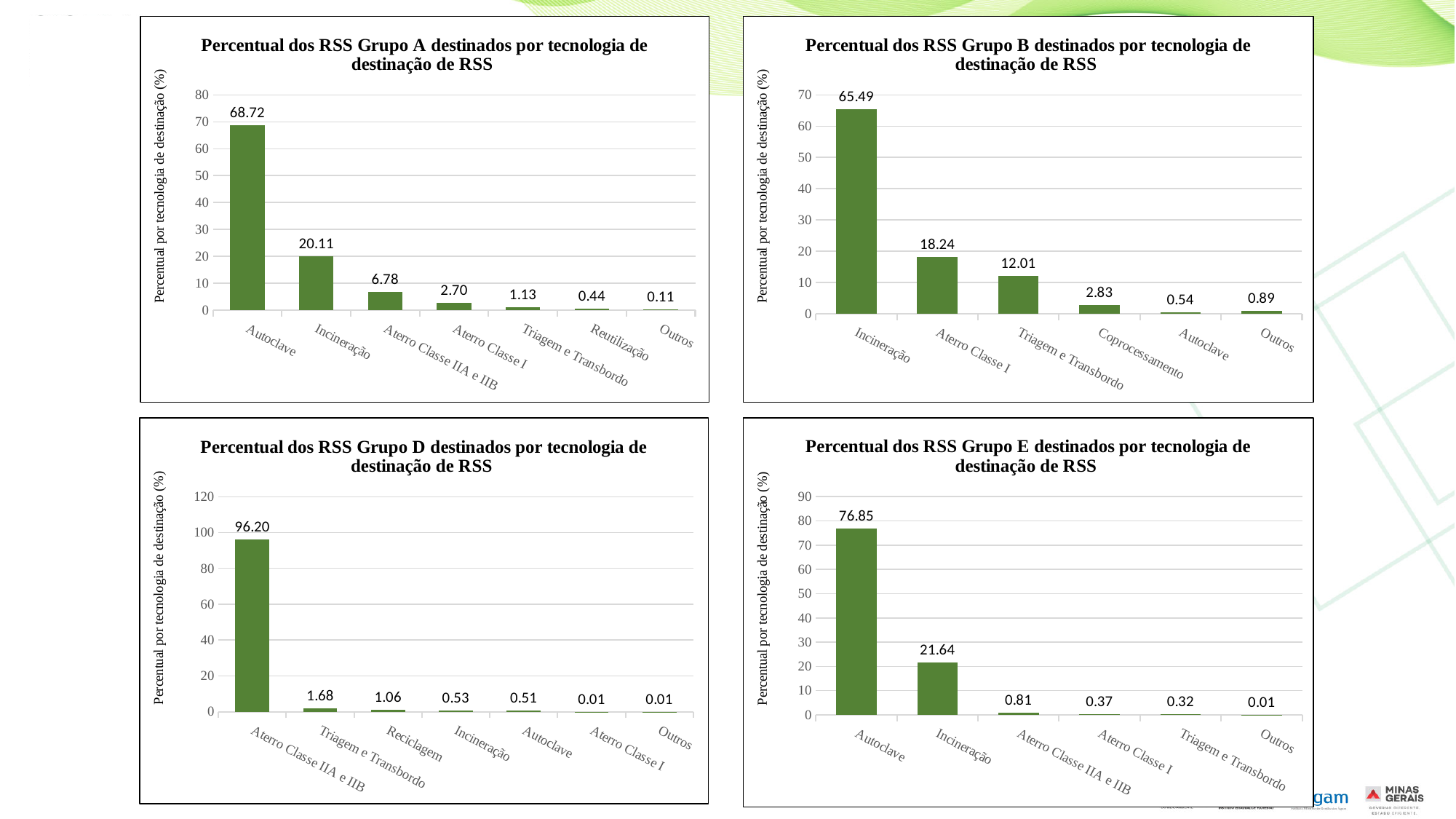
In the chart 'Percentual dos RSS Grupo D destinados por tecnologia de destinação de RSS', which category has the highest value? Aterro Classe IIA e IIB In the chart 'Percentual dos RSS Grupo B destinados por tecnologia de destinação de RSS', what is the value for Triagem e Transbordo? 12.01 In the chart 'Percentual dos RSS Grupo E destinados por tecnologia de destinação de RSS', is the value for Autoclave greater or less than 70? greater In the chart 'Percentual dos RSS Grupo E destinados por tecnologia de destinação de RSS', what is the value for Incineração? 21.64 What kind of chart is 'Percentual dos RSS Grupo D destinados por tecnologia de destinação de RSS'? Bar chart What is the y-axis label of the chart 'Percentual dos RSS Grupo A destinados por tecnologia de destinação de RSS'? Percentual por tecnologia de destinação (%) In the chart 'Percentual dos RSS Grupo A destinados por tecnologia de destinação de RSS', what is the difference between the values for Autoclave and Incineração? 48.61 In the chart 'Percentual dos RSS Grupo A destinados por tecnologia de destinação de RSS', what is the value for Autoclave? 68.72 In the chart 'Percentual dos RSS Grupo E destinados por tecnologia de destinação de RSS', which category has the lowest value? Outros In the chart 'Percentual dos RSS Grupo B destinados por tecnologia de destinação de RSS', which is larger, the value for Autoclave or the value for Outros? Outros How many categories are shown in the chart 'Percentual dos RSS Grupo A destinados por tecnologia de destinação de RSS'? 7 How many categories are shown in the chart 'Percentual dos RSS Grupo B destinados por tecnologia de destinação de RSS'? 6